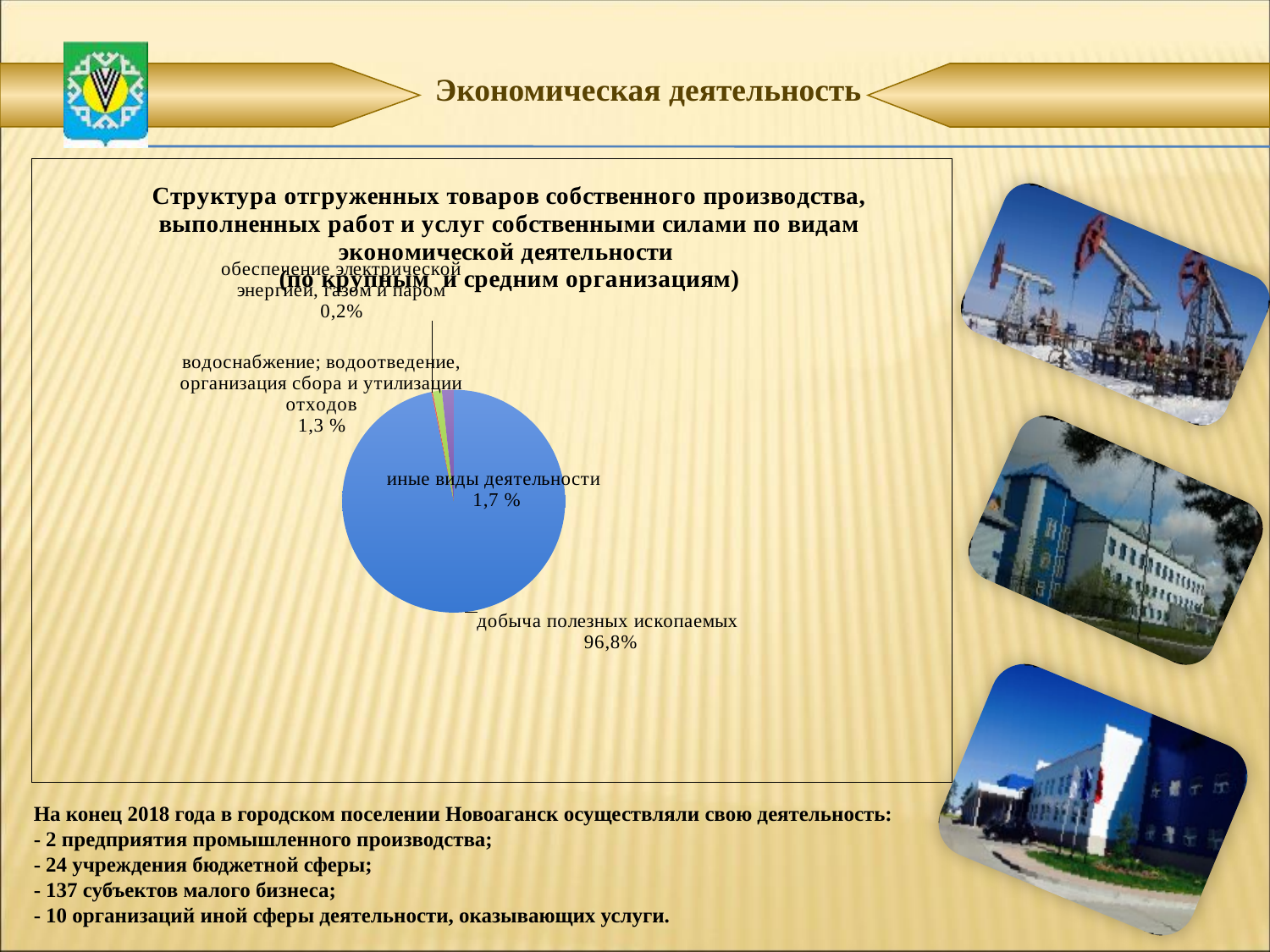
Which category has the largest slice of the pie? добыча полезных ископаемых How many categories are shown in the pie chart? 4 What is the value for обеспечение электрической энергией, газом и паром? 0,2% What percentage is shown for водоснабжение; водоотведение, организация сбора и утилизации отходов? 1,3 % What is the value shown for иные виды деятельности? 1,7 % What is the difference in percentage points between иные виды деятельности and водоснабжение; водоотведение, организация сбора и утилизации отходов? 0,4 Which category has the smallest slice of the pie? обеспечение электрической энергией, газом и паром What is the difference in percentage points between добыча полезных ископаемых and иные виды деятельности? 95,1 What colour is the slice for добыча полезных ископаемых? blue What share of the pie does добыча полезных ископаемых account for? 96,8% Which is larger: иные виды деятельности or водоснабжение; водоотведение, организация сбора и утилизации отходов? иные виды деятельности What type of chart is shown on the slide? pie chart